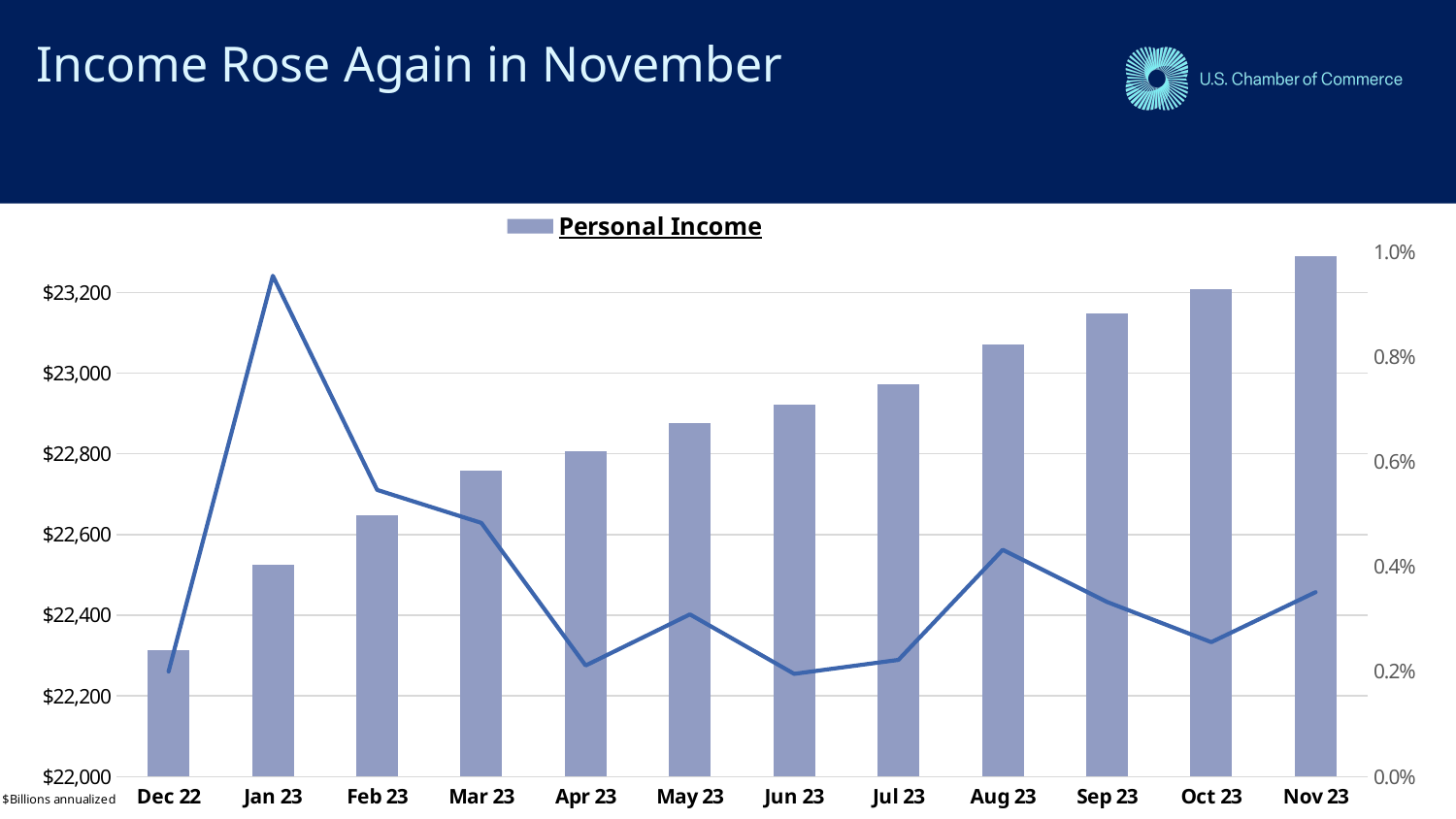
How many months are shown along the x axis? 12 Is the Personal Income bar for Jul 23 greater or less than $23,000? less Do the Personal Income bars rise or fall from Dec 22 to Nov 23? rise Which is larger, the Personal Income bar for Aug 23 or for Mar 23? Aug 23 How many series does the legend list? 1 Which month has the tallest Personal Income bar? Nov 23 In which month does the line series reach its highest point? Jan 23 Is the Personal Income bar for Nov 23 greater or less than $23,200? greater What kind of chart is shown on the slide? bar chart with a line overlay What is the series name shown in the chart legend? Personal Income Is the Personal Income bar for Dec 22 greater or less than $22,400? less Which month has the shortest Personal Income bar? Dec 22